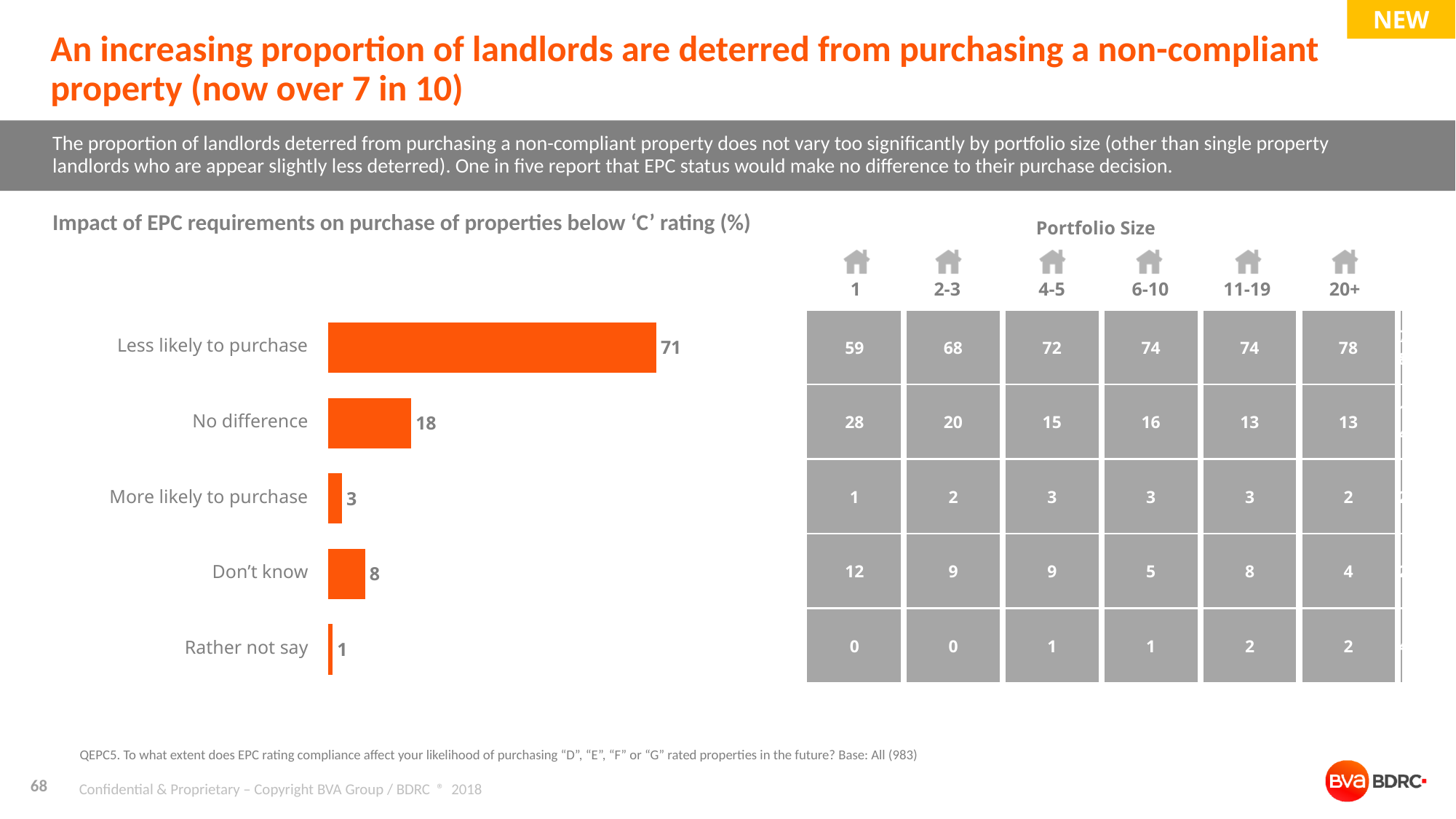
What is the difference between 'Less likely to purchase' and 'No difference' in the bar chart? 53 How many categories are shown in the bar chart? 5 In the Portfolio Size table, what is the 'Less likely to purchase' value for landlords with 20+ properties? 78 Which category has the highest value in the bar chart? Less likely to purchase What is the title of the bar chart? Impact of EPC requirements on purchase of properties below 'C' rating (%) Which is larger in the bar chart: 'Don't know' or 'More likely to purchase'? Don't know Which category has the lowest value in the bar chart? Rather not say What is the value for 'Less likely to purchase' in the bar chart? 71 What kind of chart is used to show the impact of EPC requirements on purchase? Bar chart What is the value for 'No difference' in the bar chart? 18 What is the value for 'Don't know' in the bar chart? 8 In the Portfolio Size table, what is the 'No difference' value for landlords with 1 property? 28